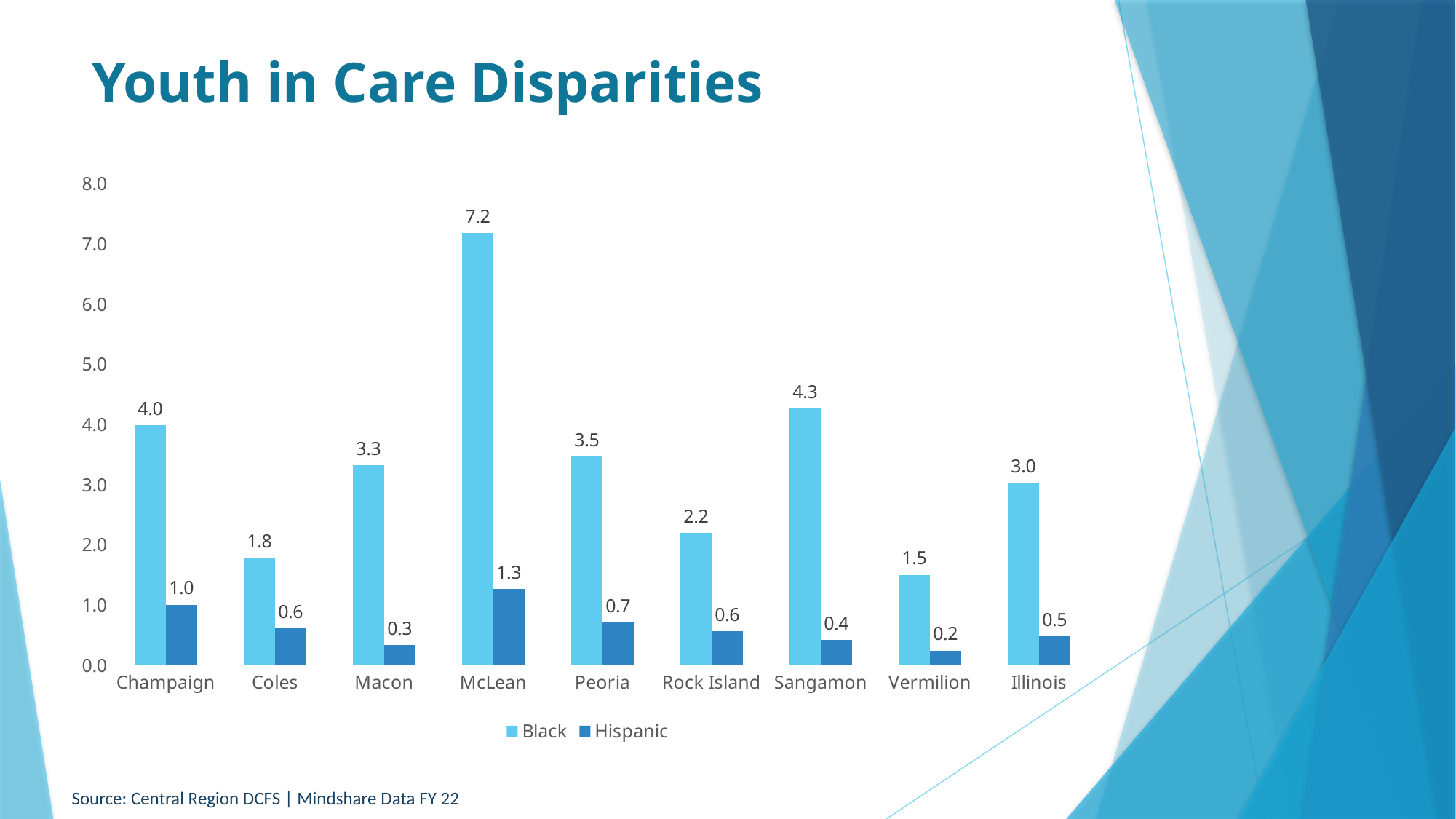
How many series does the legend list? 2 What is the Hispanic value for Rock Island? 0.6 What is the Black value for McLean? 7.2 What kind of chart is shown on the slide? Bar chart What is the Black value for Illinois? 3.0 What is the difference between the Black and Hispanic values for Sangamon? 3.9 How many categories are shown on the x axis? 9 Which is larger, the Black value for Peoria or the Black value for Macon? Peoria What is the title of the slide? Youth in Care Disparities Which category has the lowest Hispanic value? Vermilion What is the Hispanic value for Champaign? 1.0 Which category has the highest Black value? McLean